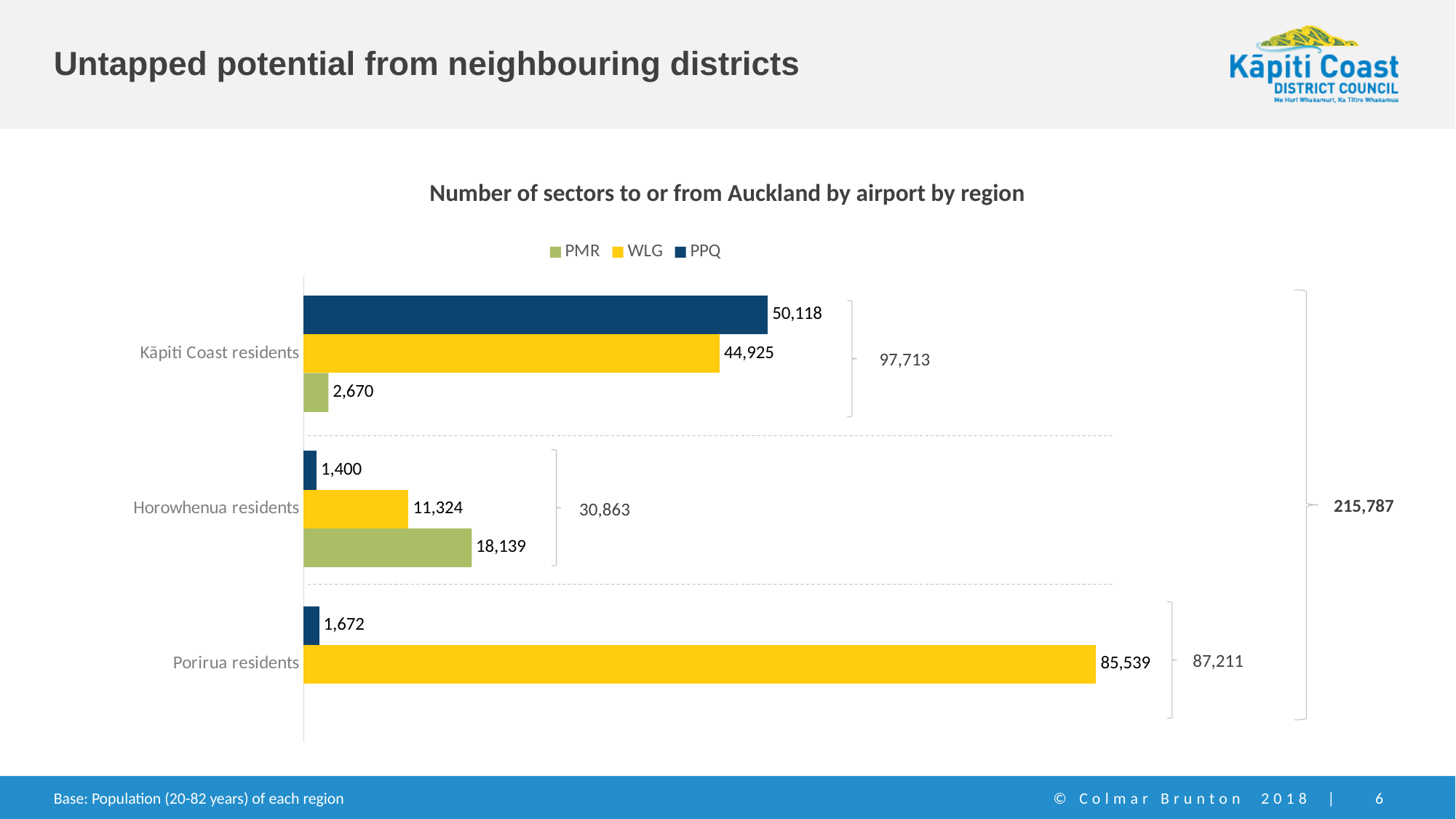
What is the PPQ value for Kāpiti Coast residents? 50,118 What is the PMR value for Horowhenua residents? 18,139 What is the overall total across all three regions shown on the chart? 215,787 Which region has the highest WLG value? Porirua residents What kind of chart is shown on the slide? Bar chart Which region has the lowest PPQ value? Horowhenua residents How many regions are shown on the chart? 3 What is the total number of sectors shown for Horowhenua residents? 30,863 How many series does the legend list? 3 What is the WLG value for Porirua residents? 85,539 What is the difference between the PPQ and WLG values for Kāpiti Coast residents? 5,193 Which is larger for Horowhenua residents, the WLG value or the PMR value? PMR